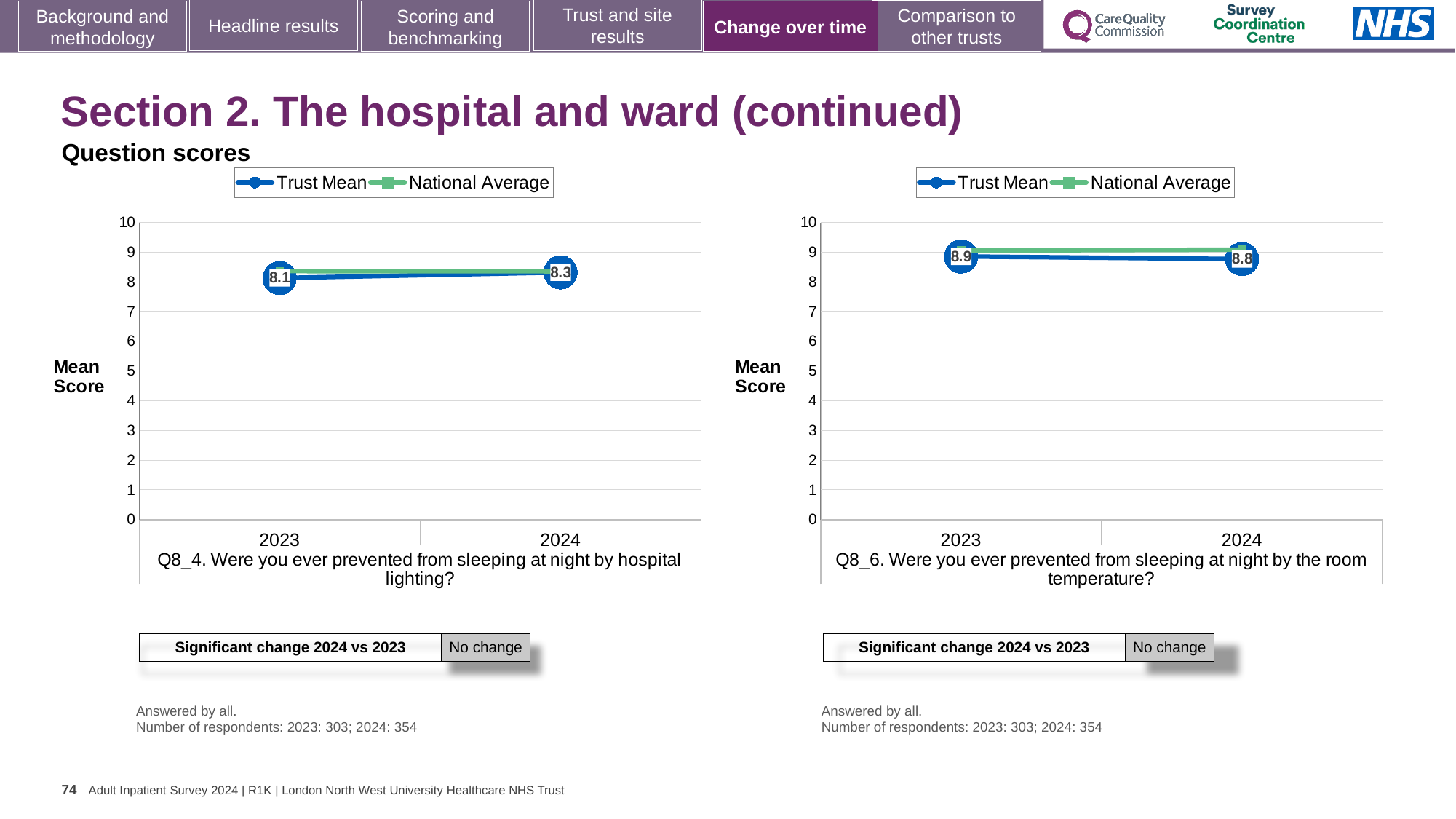
In the left chart (Q8_4), is the National Average for 2023 greater or less than 7? greater How many series does the legend of the left chart list? 2 In the left chart (Q8_4), does the Trust Mean rise or fall from 2023 to 2024? rise In the left chart (Q8_4), by how much did the Trust Mean change from 2023 to 2024? 0.2 In the right chart (Q8_6), which year has the higher Trust Mean, 2023 or 2024? 2023 In the left chart (Q8_4, hospital lighting), what is the Trust Mean score for 2024? 8.3 What type of chart is used for Q8_6 on the right? line chart In the right chart (Q8_6, room temperature), what is the Trust Mean score for 2024? 8.8 In the right chart (Q8_6), does the Trust Mean rise or fall from 2023 to 2024? fall In the right chart (Q8_6), what is the difference between the Trust Mean for 2023 and 2024? 0.1 In the right chart (Q8_6, room temperature), what is the Trust Mean score for 2023? 8.9 In the left chart (Q8_4, hospital lighting), what is the Trust Mean score for 2023? 8.1